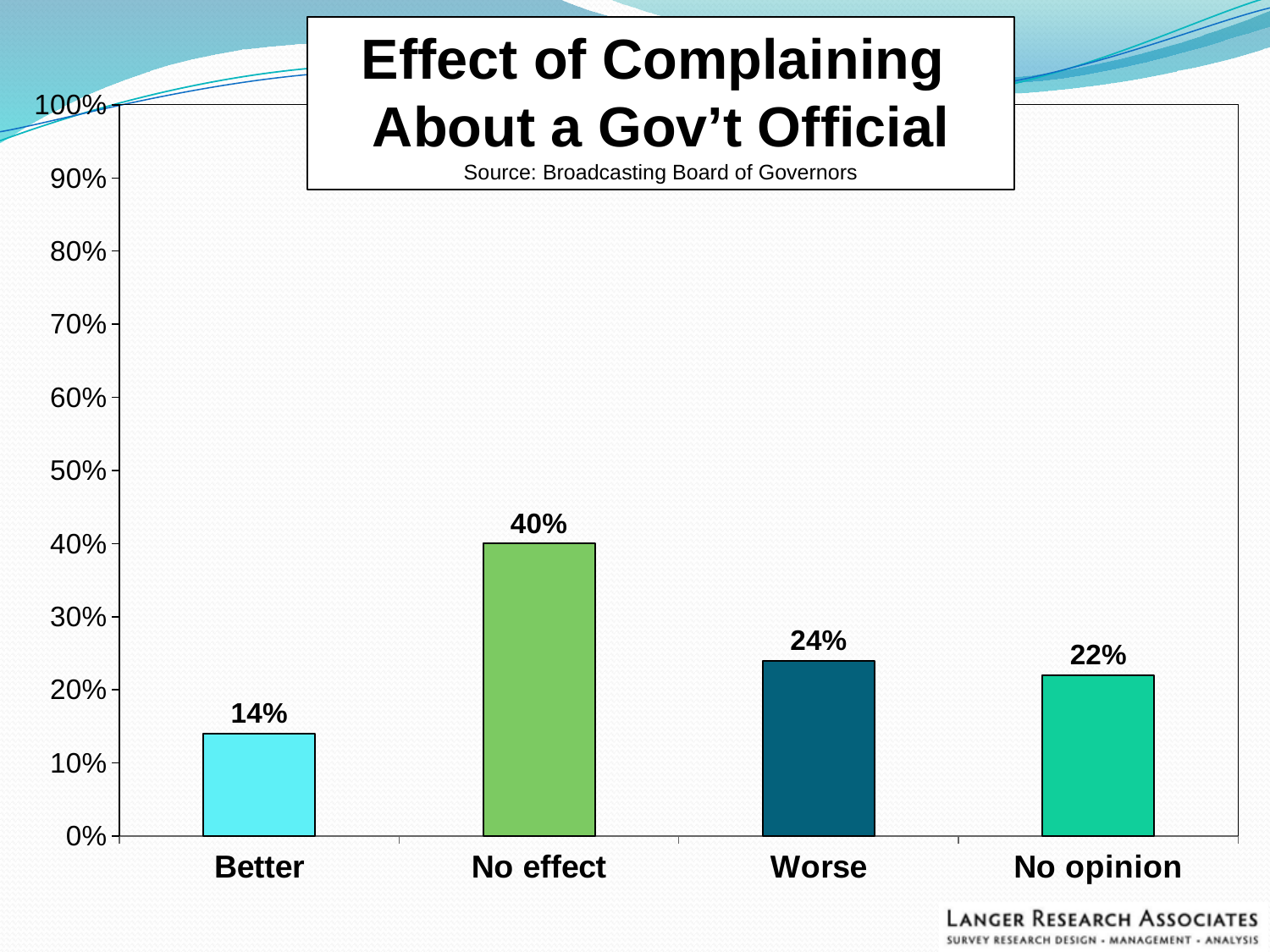
Which category has the lowest value? Better What is the value shown for the 'No effect' bar? 40% Which category has the highest value? No effect What percentage is shown for 'Worse'? 24% What percentage of respondents said complaining about a government official made things better? 14% How many categories are shown on the x axis? 4 Which is larger, the value for 'Worse' or the value for 'Better'? Worse What source is cited for the chart? Broadcasting Board of Governors What is the value for 'No opinion'? 22% What is the difference between the 'No effect' and 'Better' values? 26% Is the value for 'No effect' greater or less than 50%? less What kind of chart is shown on the slide? Bar chart